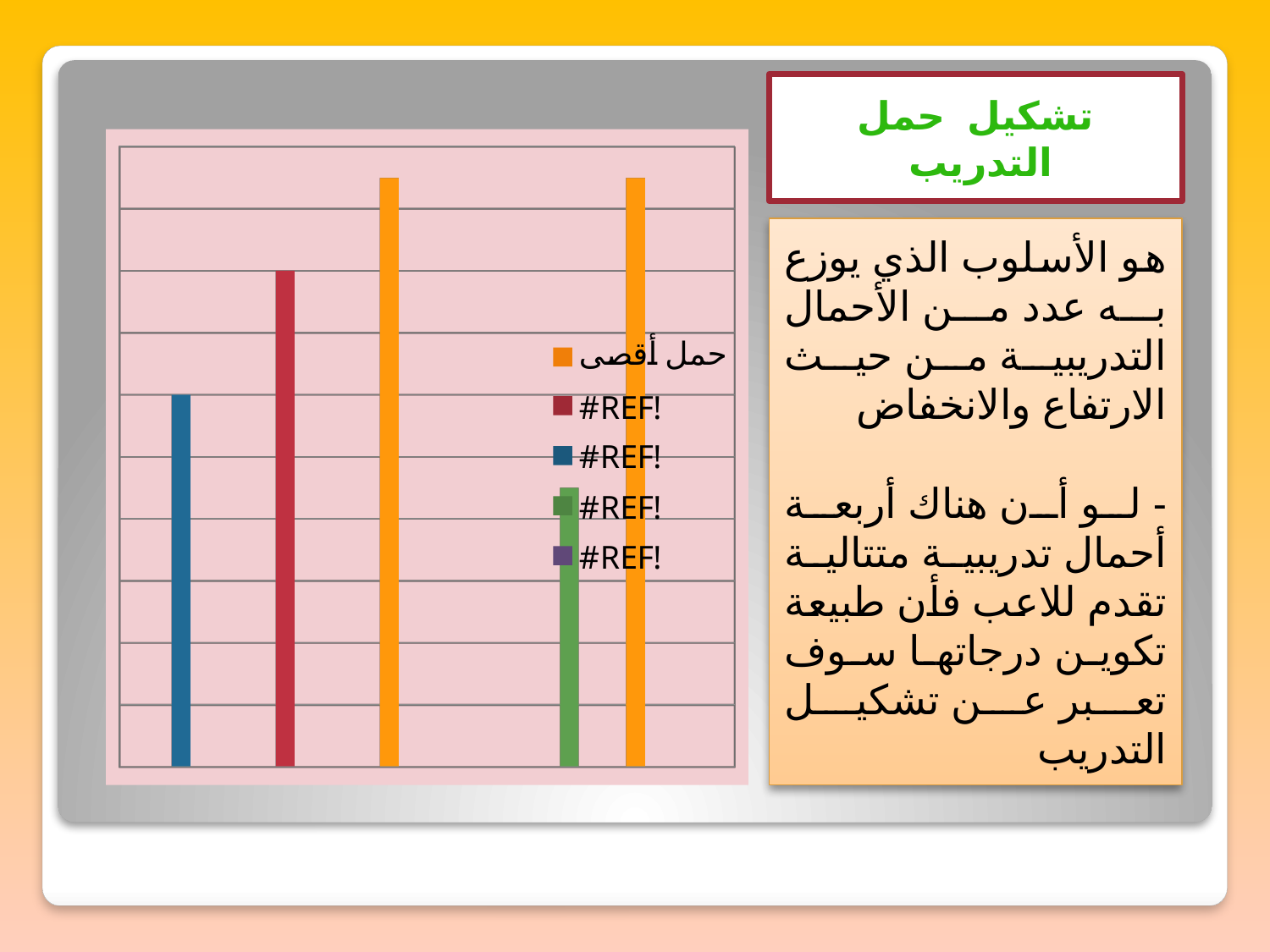
How many bars are plotted in the chart? 5 Which colour of bar is the shortest in the chart? green Which is taller, the red bar or the blue bar? red How many entries does the chart's legend list? 5 How many legend entries read "#REF!"? 4 Which colour of bar reaches the highest in the chart? orange What kind of chart is shown on the slide? bar chart Which legend entry is shown with the orange colour? حمل أقصى Which is taller, the blue bar or the green bar? blue Which is taller, the orange bar or the red bar? orange